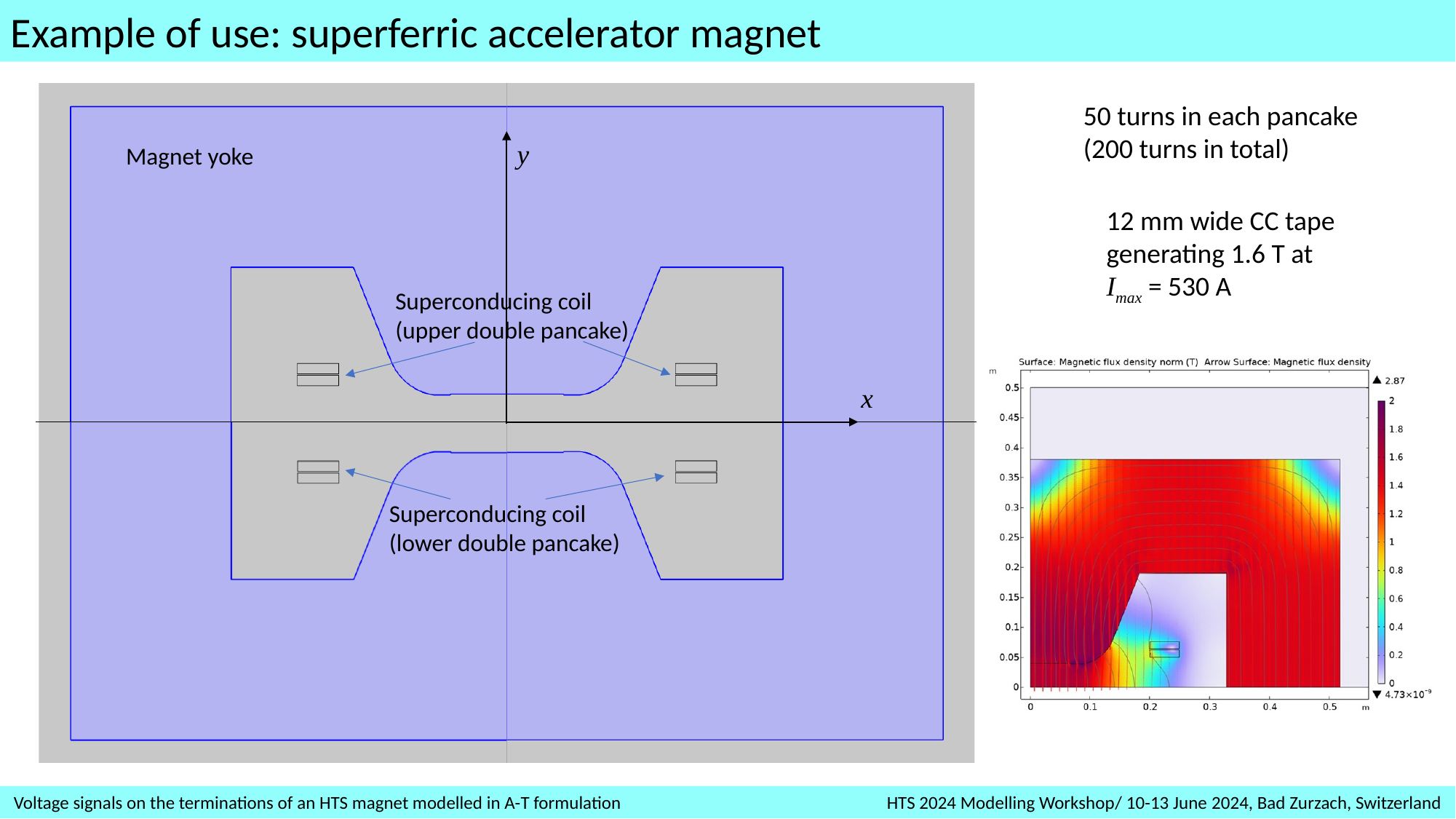
In the surface plot on the right, what is the minimum value indicated at the bottom of the colour bar? 4.73×10⁻⁹ In the surface plot on the right, what unit is shown on the x and y axes? m What is the title of the colour surface plot on the right of the slide? Surface: Magnetic flux density norm (T) Arrow Surface: Magnetic flux density In the surface plot on the right, what is the highest tick value labelled on the colour bar scale? 2 In the surface plot on the right, what is the highest tick value labelled on the y axis? 0.5 In the surface plot on the right, what unit is the magnetic flux density norm given in, according to the plot title? T In the surface plot on the right, what is the highest tick value labelled on the x axis? 0.5 In the surface plot on the right, what is the maximum value indicated at the top of the colour bar? 2.87